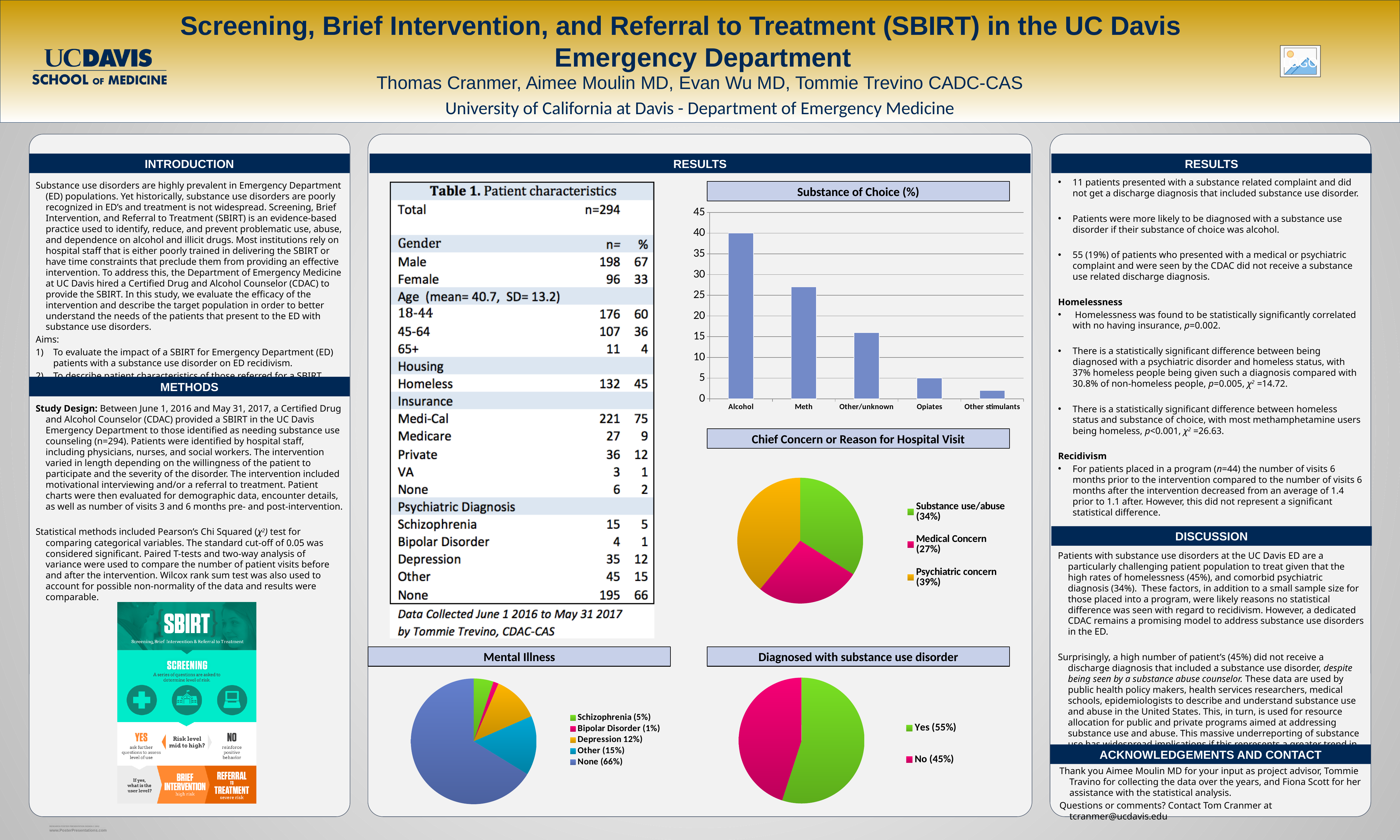
What kind of chart is the 'Substance of Choice (%)' chart? bar chart In the 'Substance of Choice (%)' chart, is the value for Other/unknown greater or less than 20? less In the 'Mental Illness' pie chart, how many categories does the legend list? 5 In the 'Diagnosed with substance use disorder' pie chart, which is larger, Yes or No? Yes In the 'Chief Concern or Reason for Hospital Visit' pie chart, which category has the smallest share? Medical Concern In the 'Mental Illness' pie chart, what percentage is Depression? 12% In the 'Chief Concern or Reason for Hospital Visit' pie chart, what share is Psychiatric concern? 39% In the 'Substance of Choice (%)' chart, how many substance categories are shown on the x axis? 5 In the 'Substance of Choice (%)' chart, is the value for Meth greater or less than 25? greater In the 'Mental Illness' pie chart, what is the difference between the None share and the Other share? 51% In the 'Substance of Choice (%)' chart, which substance has the highest bar? Alcohol In the 'Substance of Choice (%)' chart, which substance has the lowest bar? Other stimulants